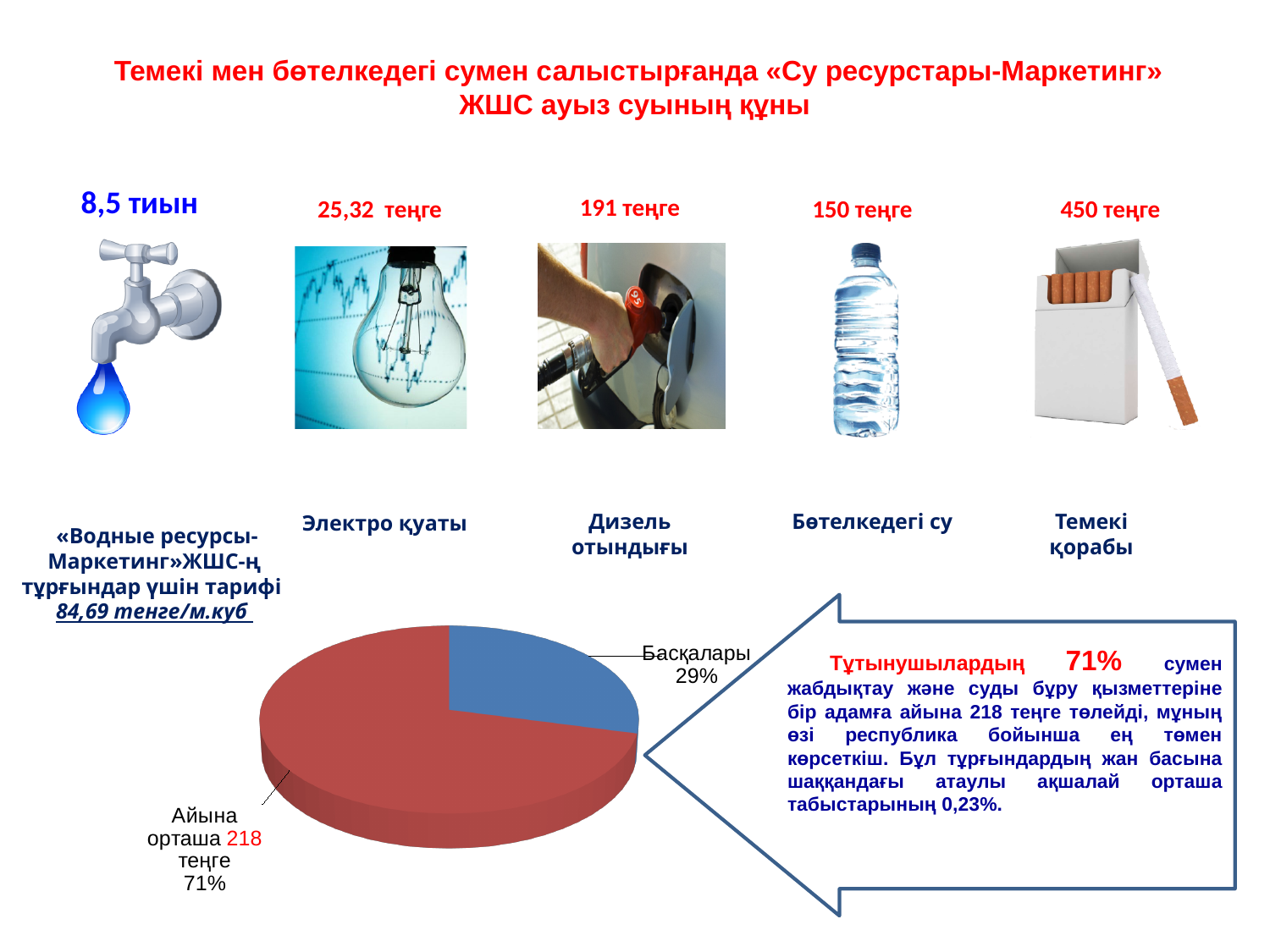
Is the share of the "Басқалары" slice greater or less than 50%? less What share of the pie does the "Басқалары" slice represent? 29% How many slices does the pie chart have? 2 What colour is the 71% slice in the pie chart? red Which slice of the pie chart is the smallest? Басқалары What is the difference in percentage points between the "Айына орташа 218 теңге" slice and the "Басқалары" slice? 42 percentage points Which slice of the pie chart is the largest? Айына орташа 218 теңге Which is larger in the pie chart: the "Басқалары" slice or the "Айына орташа 218 теңге" slice? Айына орташа 218 теңге What share of the pie does the "Айына орташа 218 теңге" slice represent? 71% What colour is the "Басқалары" slice in the pie chart? blue What kind of chart is shown at the bottom of the slide? pie chart